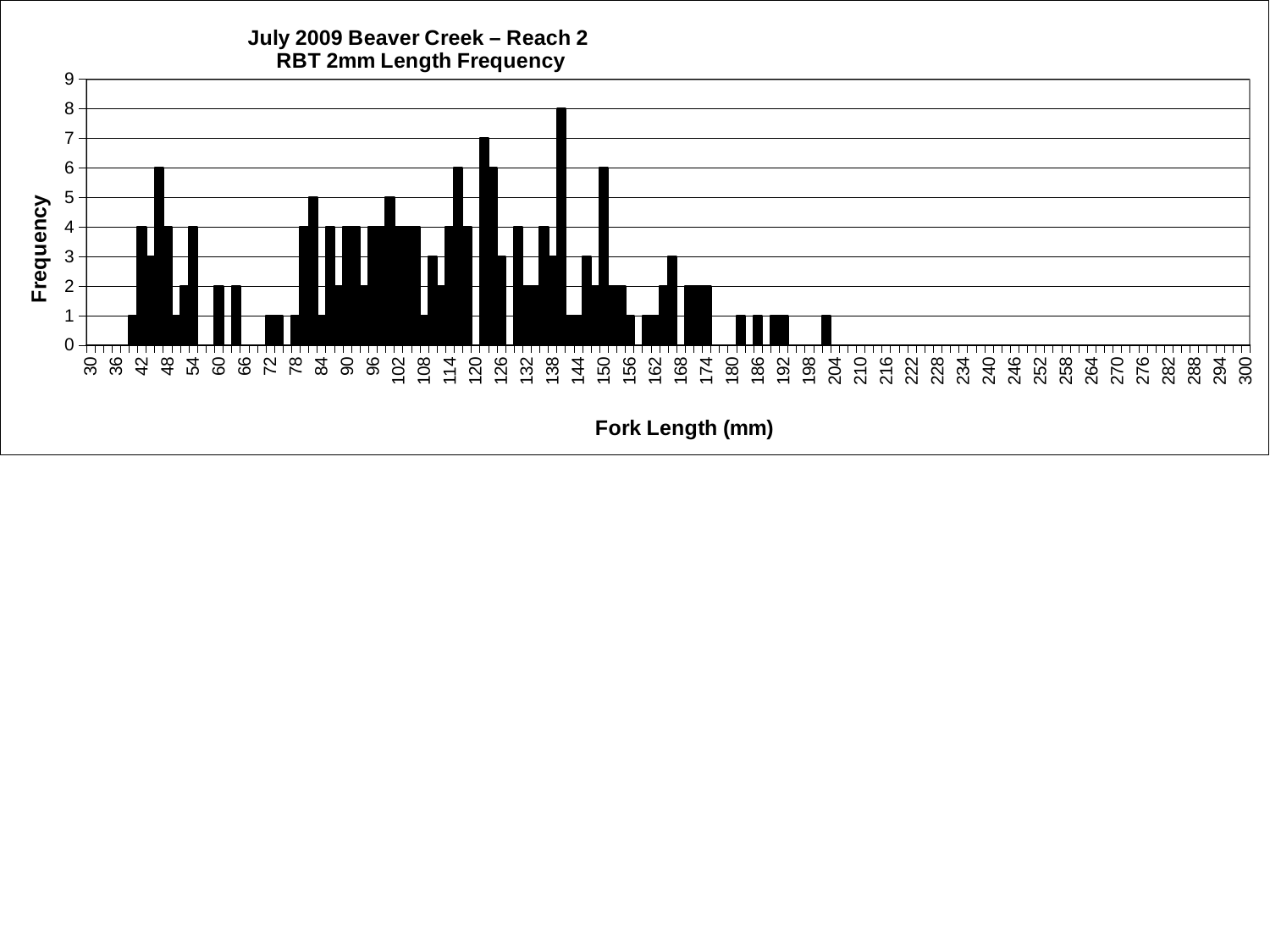
Is the value for 138 greater or less than 2? greater What is the label of the x axis? Fork Length (mm) What is the highest frequency reached by any bar in the chart? 8 Is the value for 60 greater or less than 3? less How many bars reach a frequency of 8? 1 Is the value for 270 greater or less than 1? less Which is higher, the tallest bar near 138 or the tallest bar near 120? the tallest bar near 138 What is the title of the chart? July 2009 Beaver Creek – Reach 2 RBT 2mm Length Frequency What type of chart is shown on the slide? bar chart